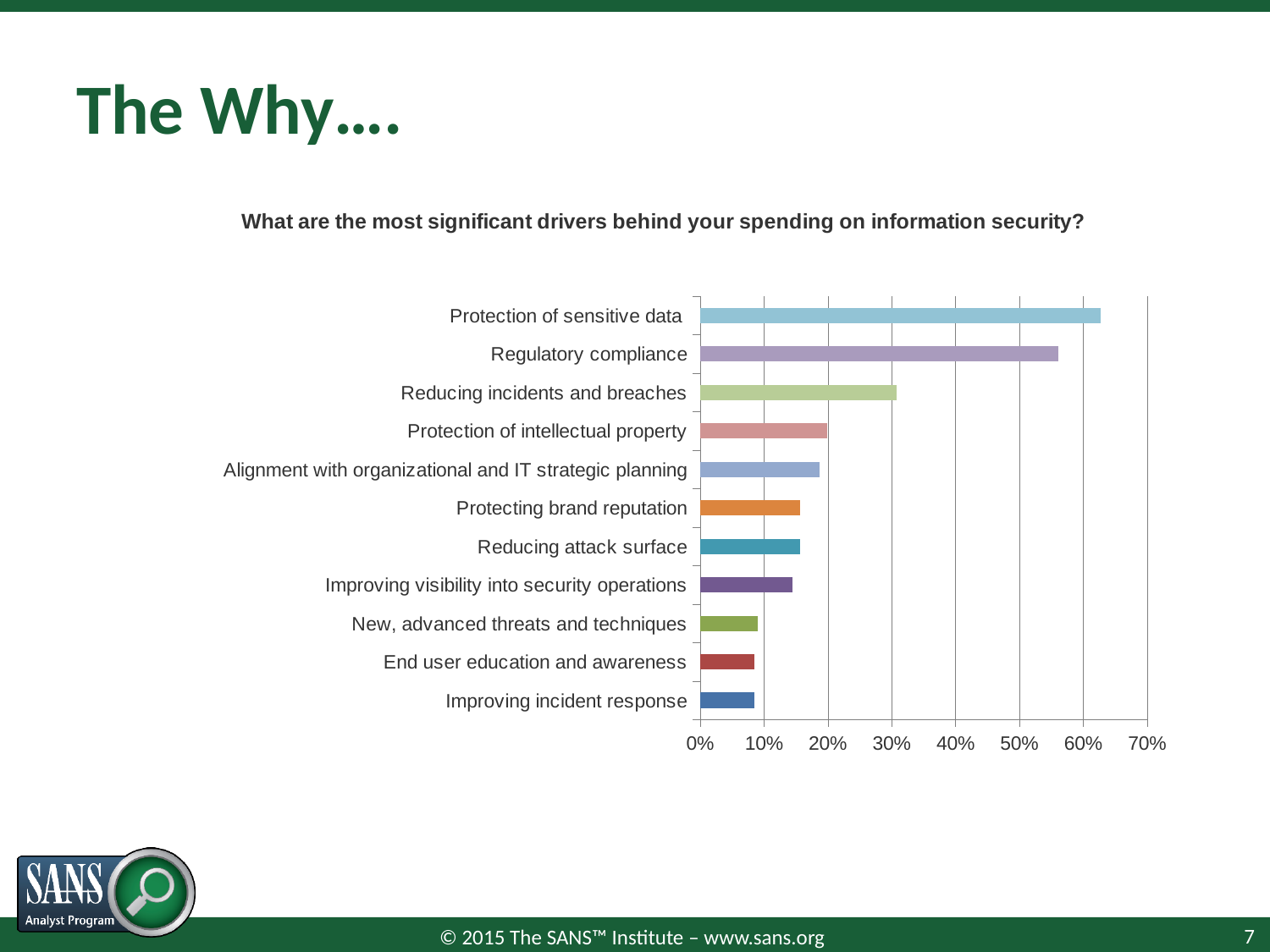
Which spending driver has the highest value in the chart? Protection of sensitive data Is the value for Regulatory compliance greater or less than 50%? greater What question is the chart titled with? What are the most significant drivers behind your spending on information security? Do the bar values increase or decrease going from the top category to the bottom category? decrease Which is larger: the value for Reducing incidents and breaches or the value for Protecting brand reputation? Reducing incidents and breaches Is the value for Protection of sensitive data greater or less than 60%? greater What kind of chart is shown on the slide? bar chart Is the value for Protection of intellectual property greater or less than 30%? less Which is larger: the value for Protection of sensitive data or the value for Regulatory compliance? Protection of sensitive data How many categories (spending drivers) are plotted in the chart? 11